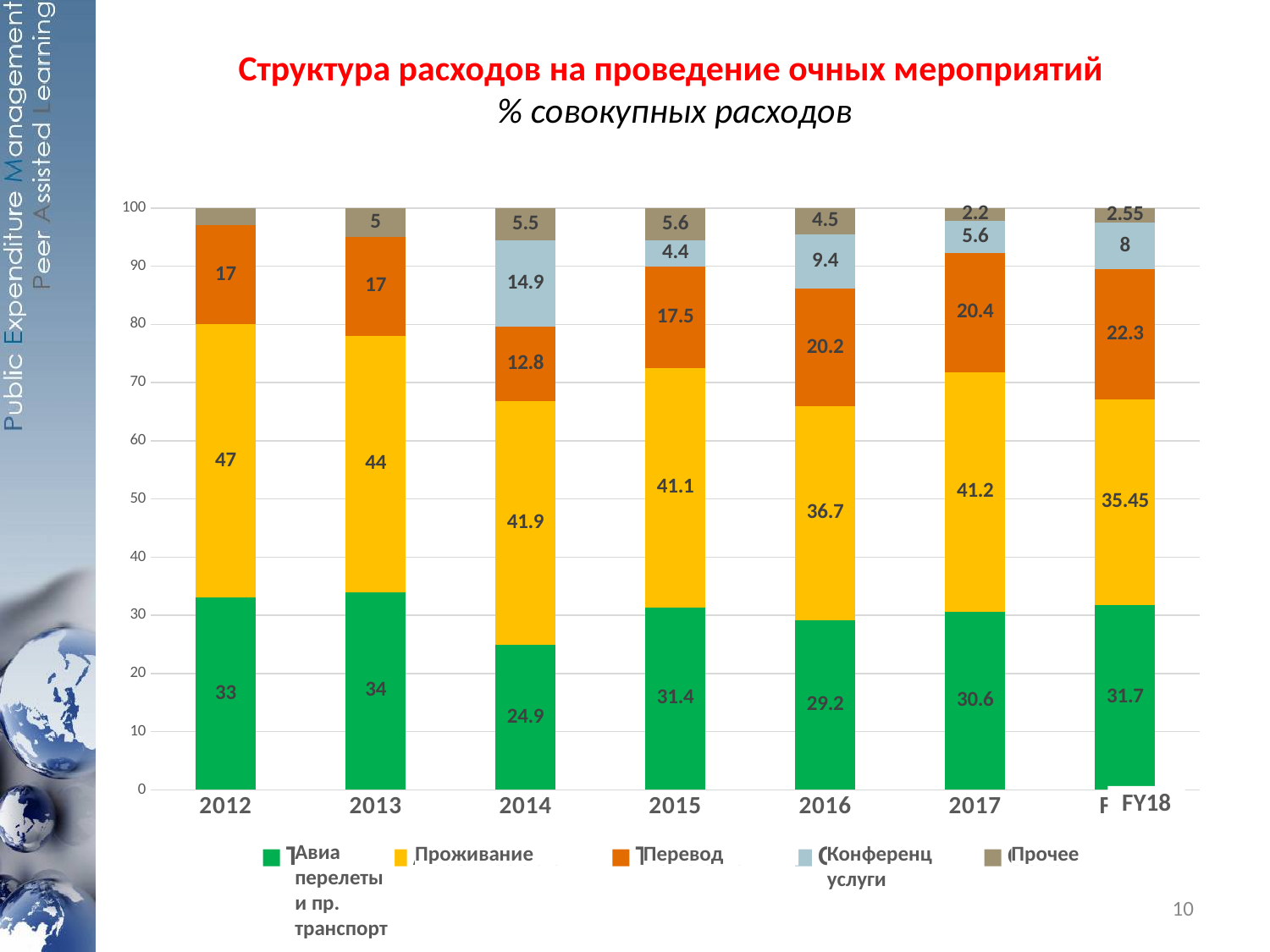
What is the value for Проживание in 2012? 47 In which year is the Авиа перелеты и пр. транспорт share lowest? 2014 Does the Перевод share rise or fall from 2014 to FY18? Rises What kind of chart is shown on the slide? Stacked bar chart How many year categories are shown on the x axis? 7 What is the difference between the Проживание values for 2012 and 2013? 3 Which is larger, the Конференц услуги value in 2014 or in 2016? 2014 What is the value for Конференц услуги in 2014? 14.9 What is the total of the stacked bar for 2016? 100 What is the value for Перевод in FY18? 22.3 How many series does the legend list? 5 In which year is the Проживание share highest? 2012